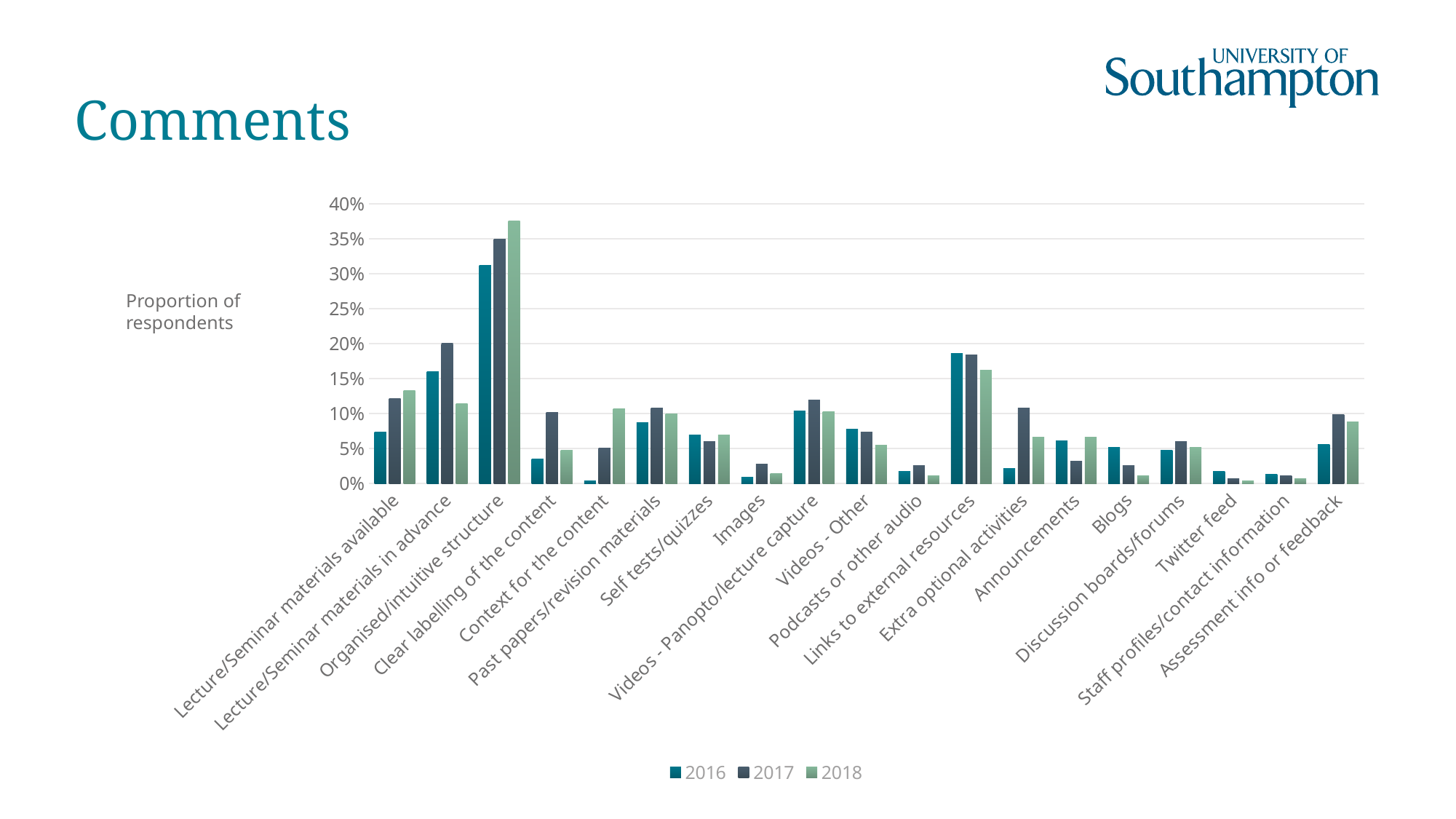
For Extra optional activities, which is larger: the 2016 value or the 2017 value? 2017 For Lecture/Seminar materials in advance, which is larger: the 2017 value or the 2018 value? 2017 Is the 2018 value for Twitter feed greater or less than 5%? less How many series does the legend list? 3 How many categories are shown on the x axis? 19 Which category has the highest value for 2016? Organised/intuitive structure Which category has the lowest value for 2016? Context for the content What kind of chart is shown on the slide? bar chart Is the 2018 value for Organised/intuitive structure greater or less than 35%? greater Is the 2016 value for Links to external resources greater or less than 15%? greater What is the label on the vertical axis of the chart? Proportion of respondents Which category has the highest value for 2018? Organised/intuitive structure